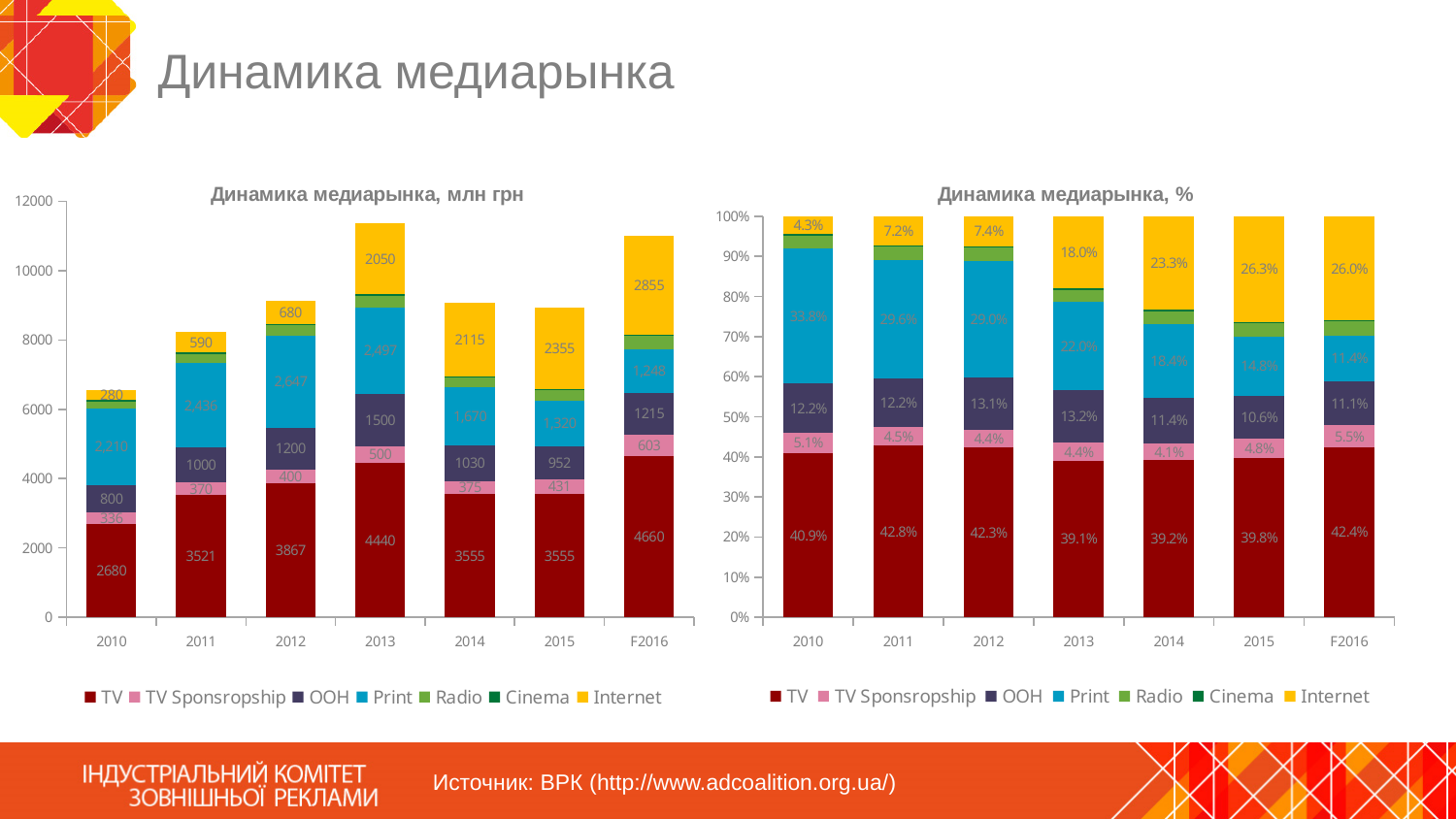
In the chart 'Динамика медиарынка, %', what is the TV share for 2011? 42.8% In the chart 'Динамика медиарынка, млн грн', what is the TV value for 2013? 4440 In the chart 'Динамика медиарынка, млн грн', what is the Internet value for F2016? 2855 How many years are shown on the x axis of the chart 'Динамика медиарынка, млн грн'? 7 In the chart 'Динамика медиарынка, млн грн', which year has the lowest Internet value? 2010 How many series does the legend of the chart 'Динамика медиарынка, %' list? 7 In the chart 'Динамика медиарынка, %', does the Print share rise or fall from 2010 to F2016? fall In the chart 'Динамика медиарынка, млн грн', which year has the highest TV value? F2016 In the chart 'Динамика медиарынка, млн грн', what is the OOH value for 2012? 1200 In the chart 'Динамика медиарынка, млн грн', which is larger in 2014: the Print value or the Internet value? Internet In the chart 'Динамика медиарынка, млн грн', what is the difference between the Internet values for 2013 and 2012? 1370 In the chart 'Динамика медиарынка, %', what is the Print share for 2015? 14.8%